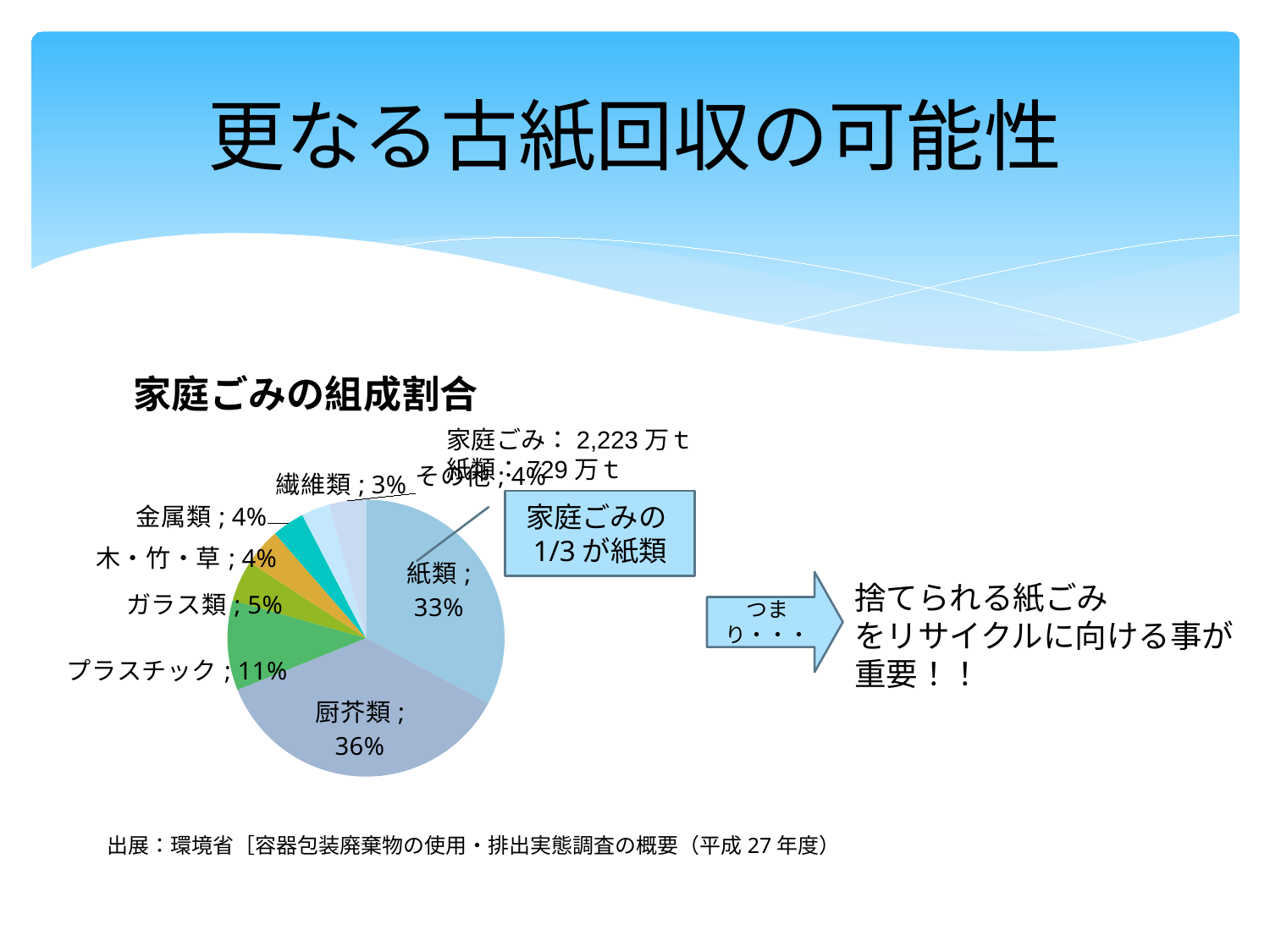
What share of the pie does 厨芥類 represent? 36% What share of the pie does 紙類 represent? 33% What is the title of the chart? 家庭ごみの組成割合 How many categories are shown in the pie chart? 8 What is the value shown for ガラス類? 5% Which is larger, the share of プラスチック or the share of ガラス類? プラスチック Which category has the largest slice of the pie? 厨芥類 What is the difference between the shares of 厨芥類 and 紙類? 3% What kind of chart is shown on the slide? pie chart What is the value shown for プラスチック? 11% What is the value shown for 繊維類? 3% Which category has the smallest slice of the pie? 繊維類